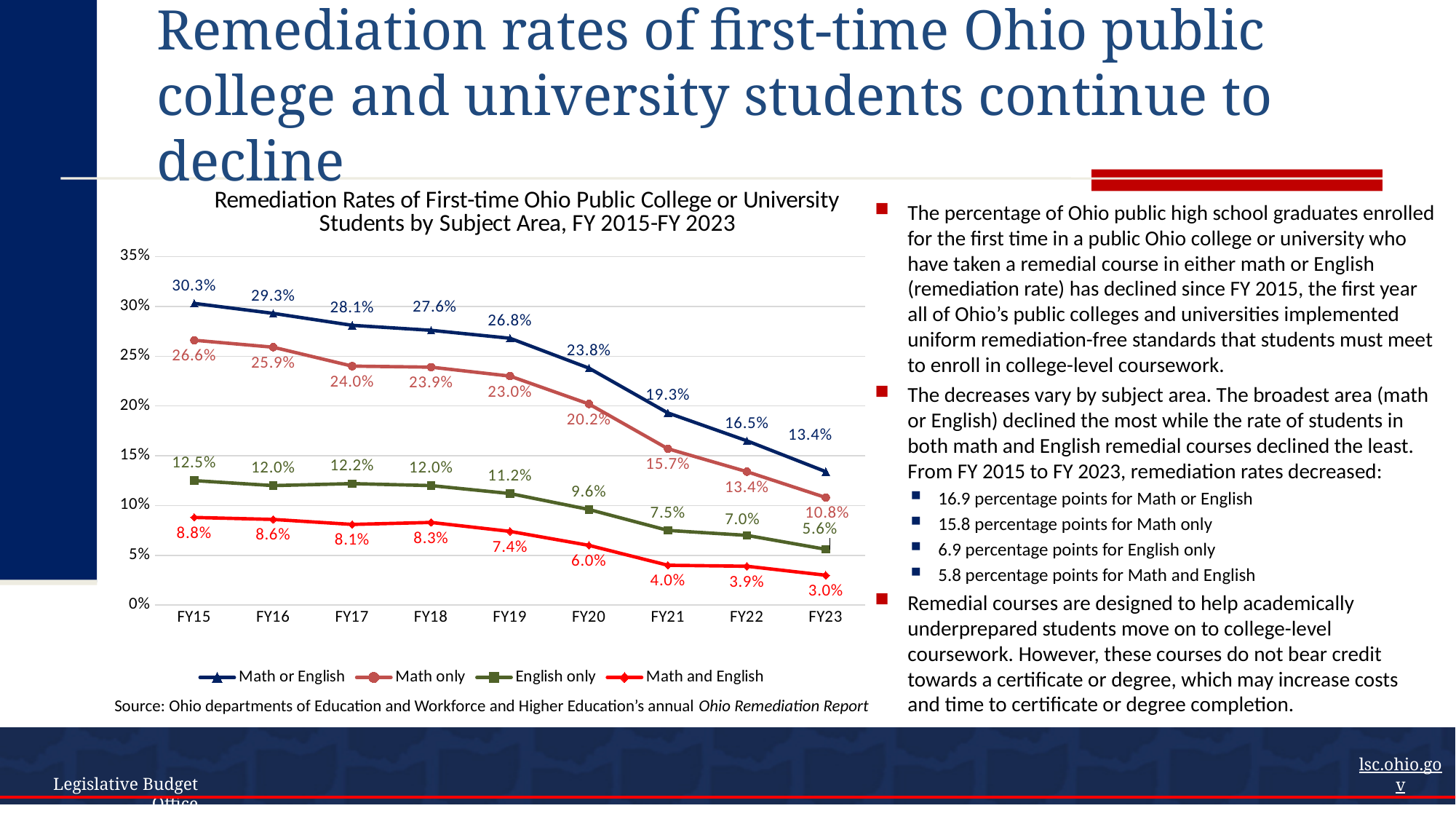
What is the Math and English remediation rate for FY21? 4.0% Which is larger in FY19: the Math only rate or the English only rate? Math only In which fiscal year is the English only remediation rate highest? FY15 How many series does the legend list? 4 What is the English only remediation rate for FY23? 5.6% Do the Math and English remediation rates rise or fall from FY15 to FY23? Fall What is the Math or English remediation rate for FY15? 30.3% How many fiscal years are plotted on the x axis? 9 In which fiscal year is the Math or English remediation rate lowest? FY23 What is the Math only remediation rate for FY20? 20.2% What is the difference between the Math or English rate in FY15 and FY23? 16.9 percentage points What kind of chart is shown on the slide? Line chart